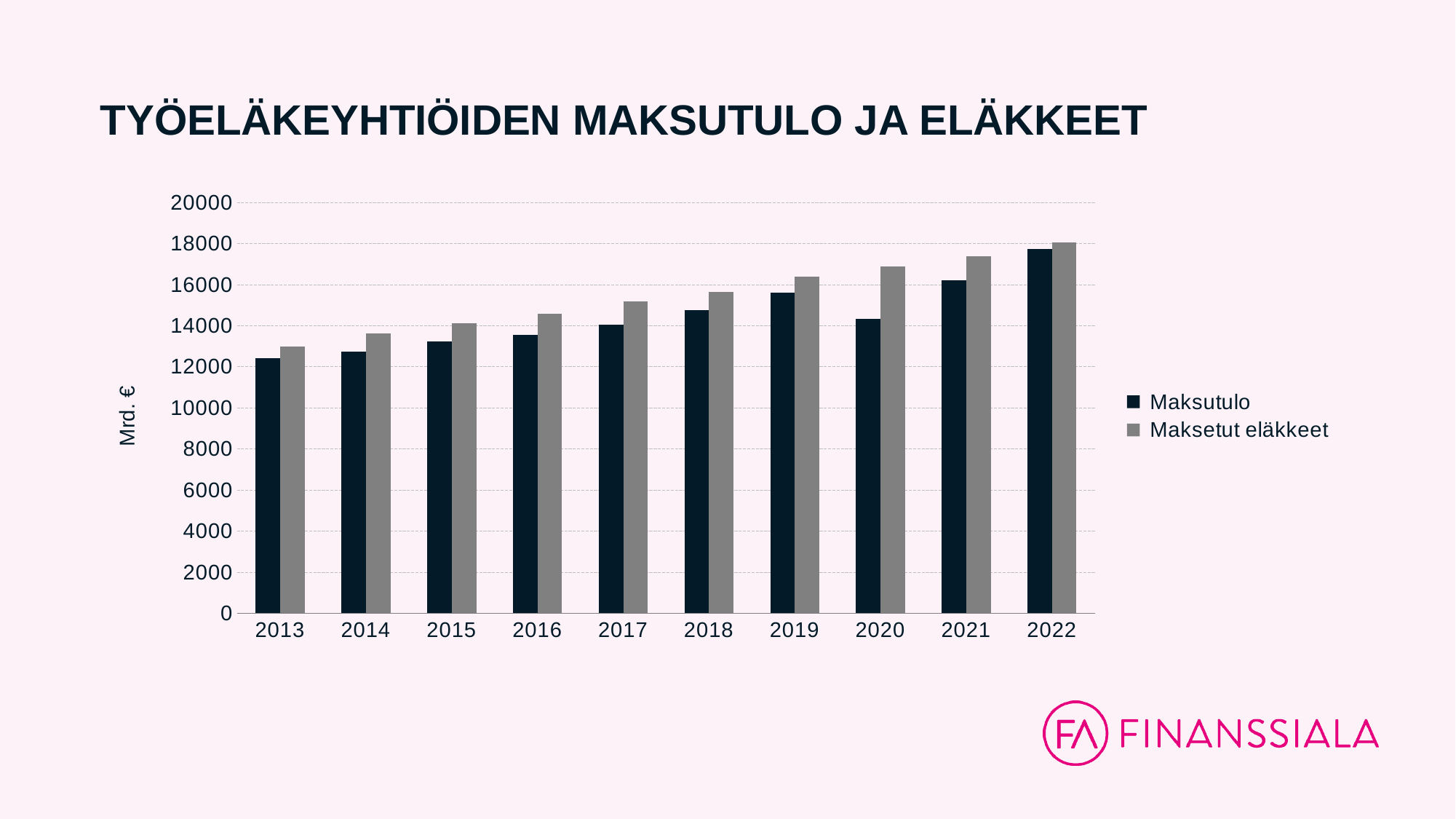
In which year is Maksetut eläkkeet highest? 2022 Is the value for Maksetut eläkkeet in 2013 greater or less than 14000? less What kind of chart is shown on the slide? bar chart Do the values for Maksetut eläkkeet rise or fall from 2013 to 2022? rise Is the value for Maksutulo in 2022 greater or less than 16000? greater What is the label on the y axis? Mrd. € In which year is Maksutulo lowest? 2013 In 2020, which is larger: Maksutulo or Maksetut eläkkeet? Maksetut eläkkeet How many series does the legend list? 2 How many years are shown on the x axis? 10 What is the title of the chart? TYÖELÄKEYHTIÖIDEN MAKSUTULO JA ELÄKKEET Is the value for Maksutulo in 2020 greater or less than 16000? less